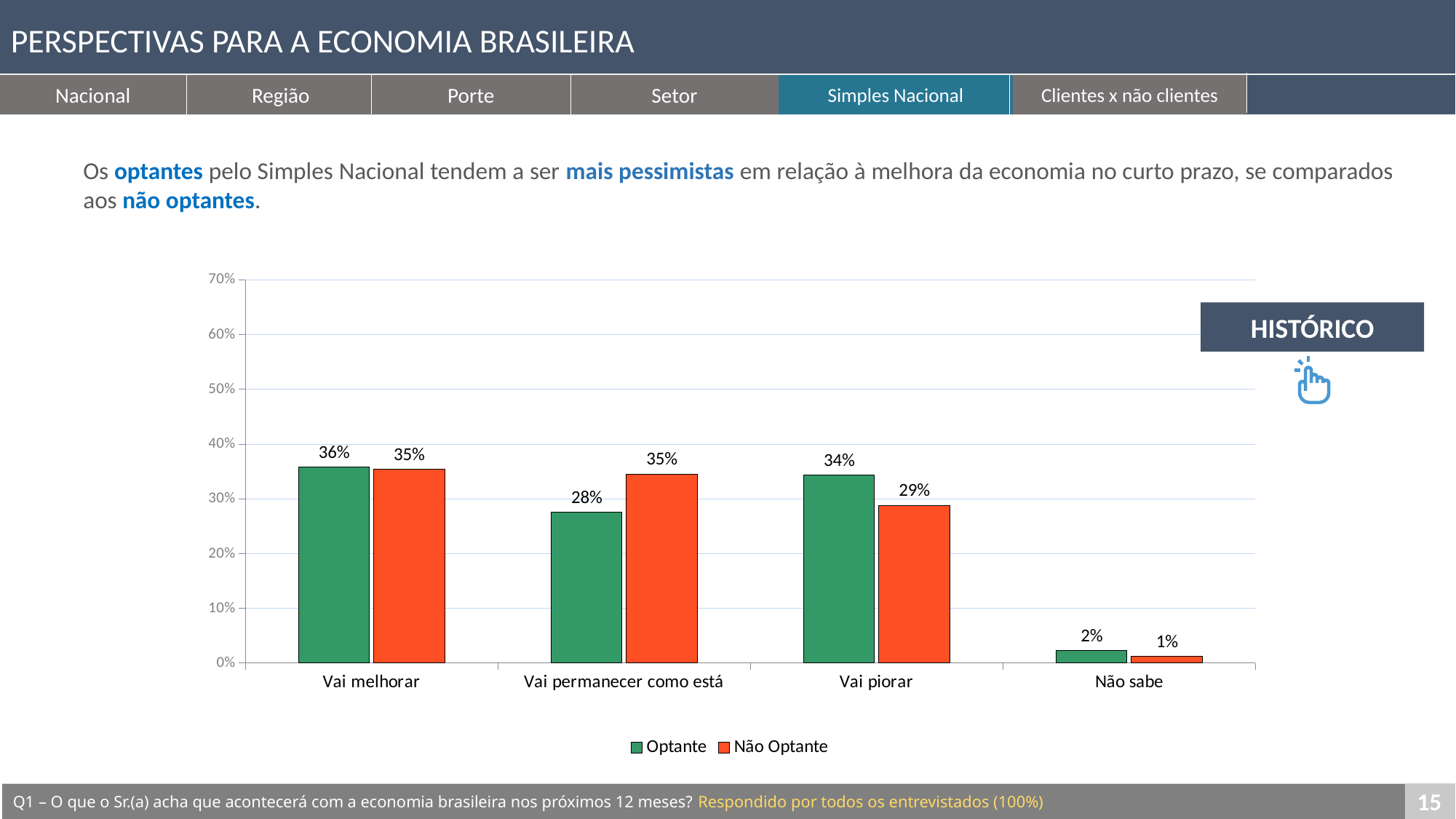
Which category has the lowest value for the Não Optante series? Não sabe How many series does the legend list? 2 Which category has the highest value for the Optante series? Vai melhorar What colour represents the Não Optante series? Orange What is the value for Optante in the 'Vai melhorar' category? 36% What is the value for Não Optante in the 'Vai permanecer como está' category? 35% How many categories are shown on the x axis? 4 What is the value for Não Optante in the 'Vai piorar' category? 29% What kind of chart is shown on the slide? Bar chart In the 'Vai permanecer como está' category, which series has the larger value, Optante or Não Optante? Não Optante What is the difference between Optante and Não Optante in the 'Vai piorar' category? 5% What is the value for Optante in the 'Não sabe' category? 2%